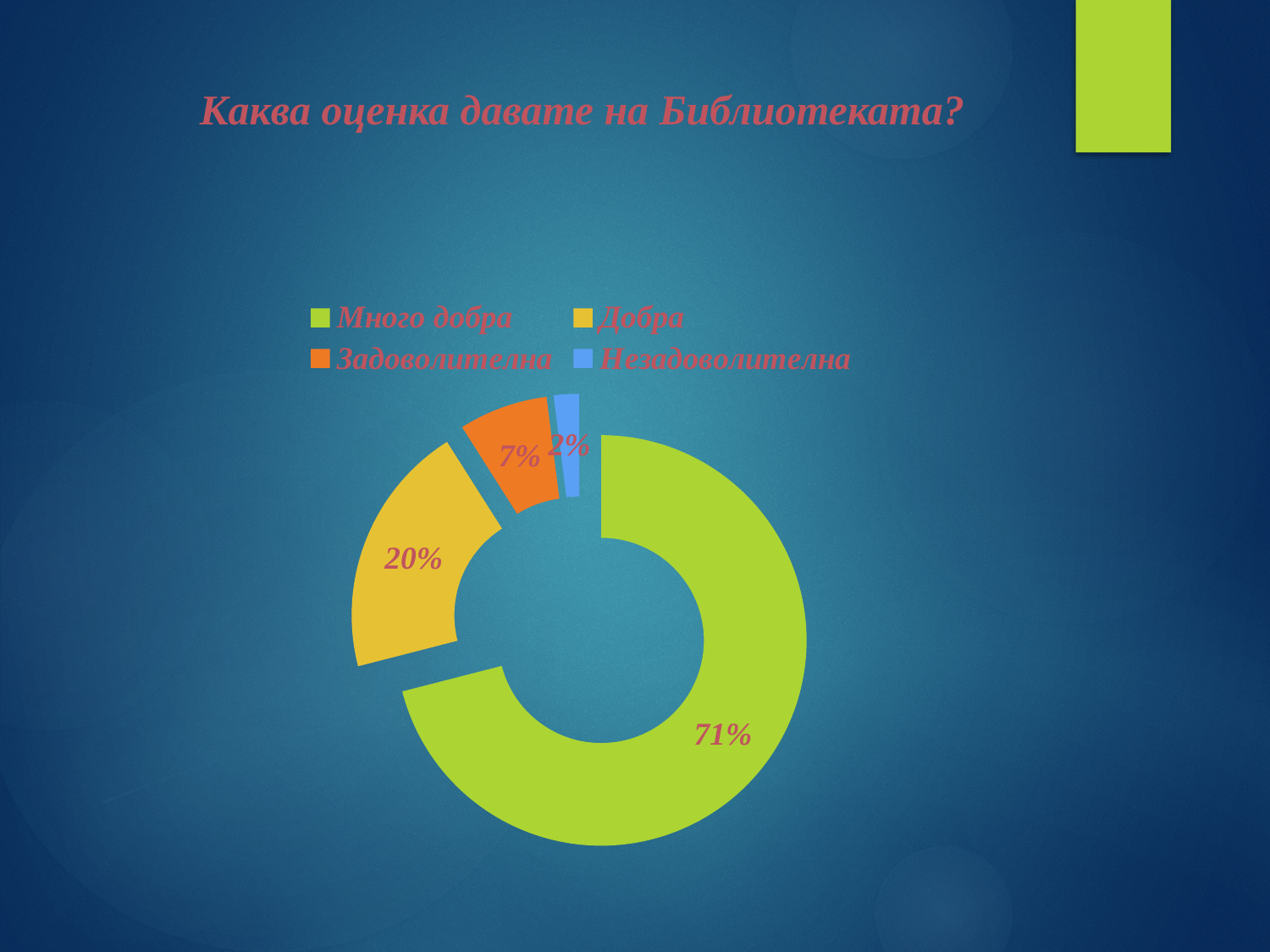
What share of the chart does the 'Много добра' slice represent? 71% What is the difference between the shares for 'Много добра' and 'Добра'? 51% Which category has the smallest share? Незадоволителна Which is larger, the share for 'Добра' or the share for 'Задоволителна'? Добра What is the value shown for 'Задоволителна'? 7% What is the title of the slide? Каква оценка давате на Библиотеката? What kind of chart is shown on the slide? Doughnut (pie) chart What is the value shown for 'Незадоволителна'? 2% What is the difference between the shares for 'Задоволителна' and 'Незадоволителна'? 5% Which category has the largest share? Много добра How many categories are shown in the chart? 4 What is the value shown for 'Добра'? 20%